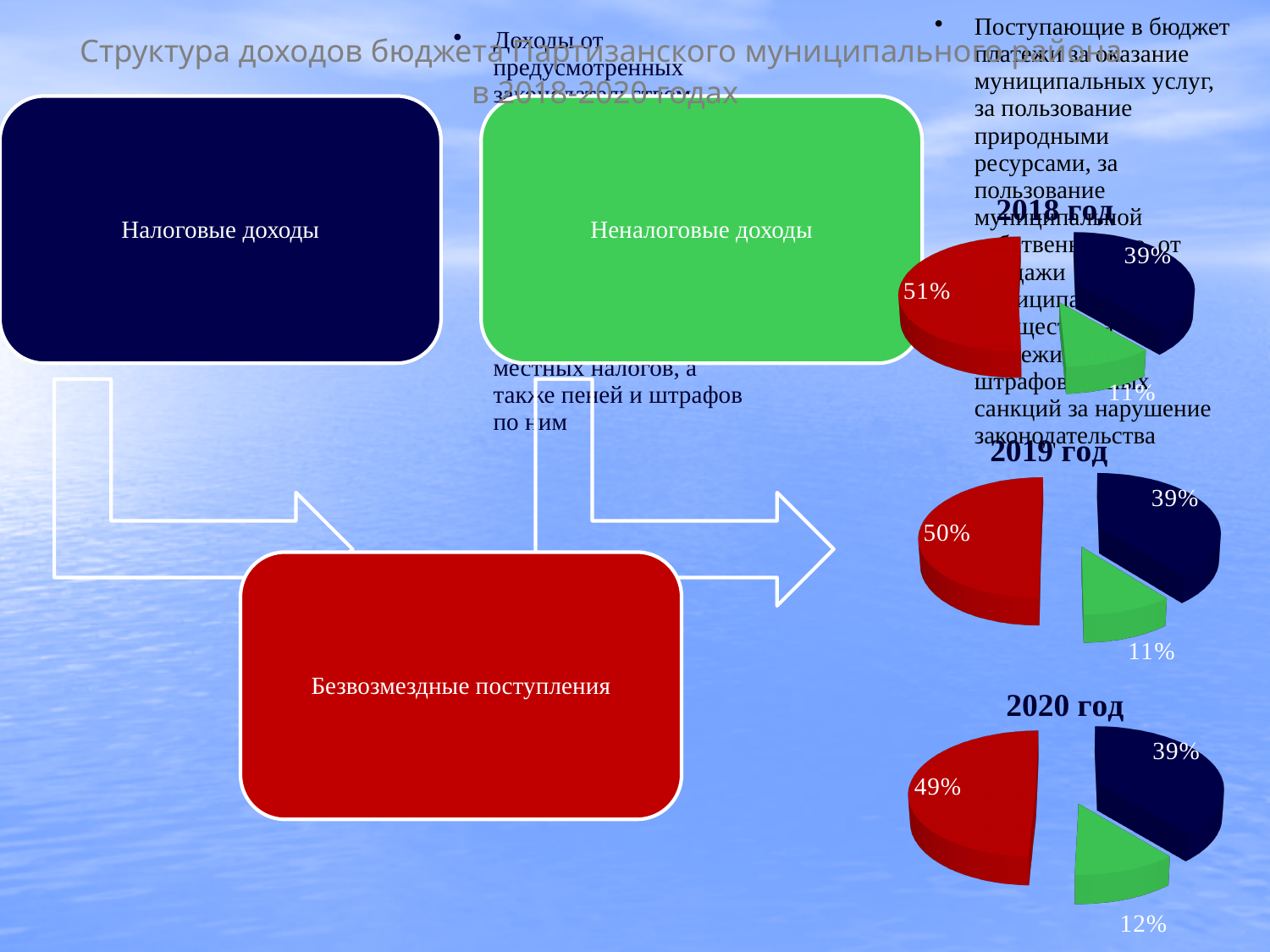
How many pie charts are shown on the slide? 3 In the 2020 год pie chart, what share does the green slice have? 12% In the 2020 год pie chart, what share does the red slice have? 49% What kind of chart is used for the 2018 год, 2019 год and 2020 год charts? pie chart In the 2018 год pie chart, what share does the red slice have? 51% In the 2020 год pie chart, which slice is the largest? the red slice (49%) In the 2018 год pie chart, which slice is the smallest? the green slice (11%) In the 2019 год pie chart, what is the difference between the red slice and the dark blue slice? 11% In the 2018 год pie chart, what share does the dark blue slice have? 39% How many slices does the 2020 год pie chart have? 3 In the 2019 год pie chart, what share does the red slice have? 50% In the 2019 год pie chart, what share does the green slice have? 11%